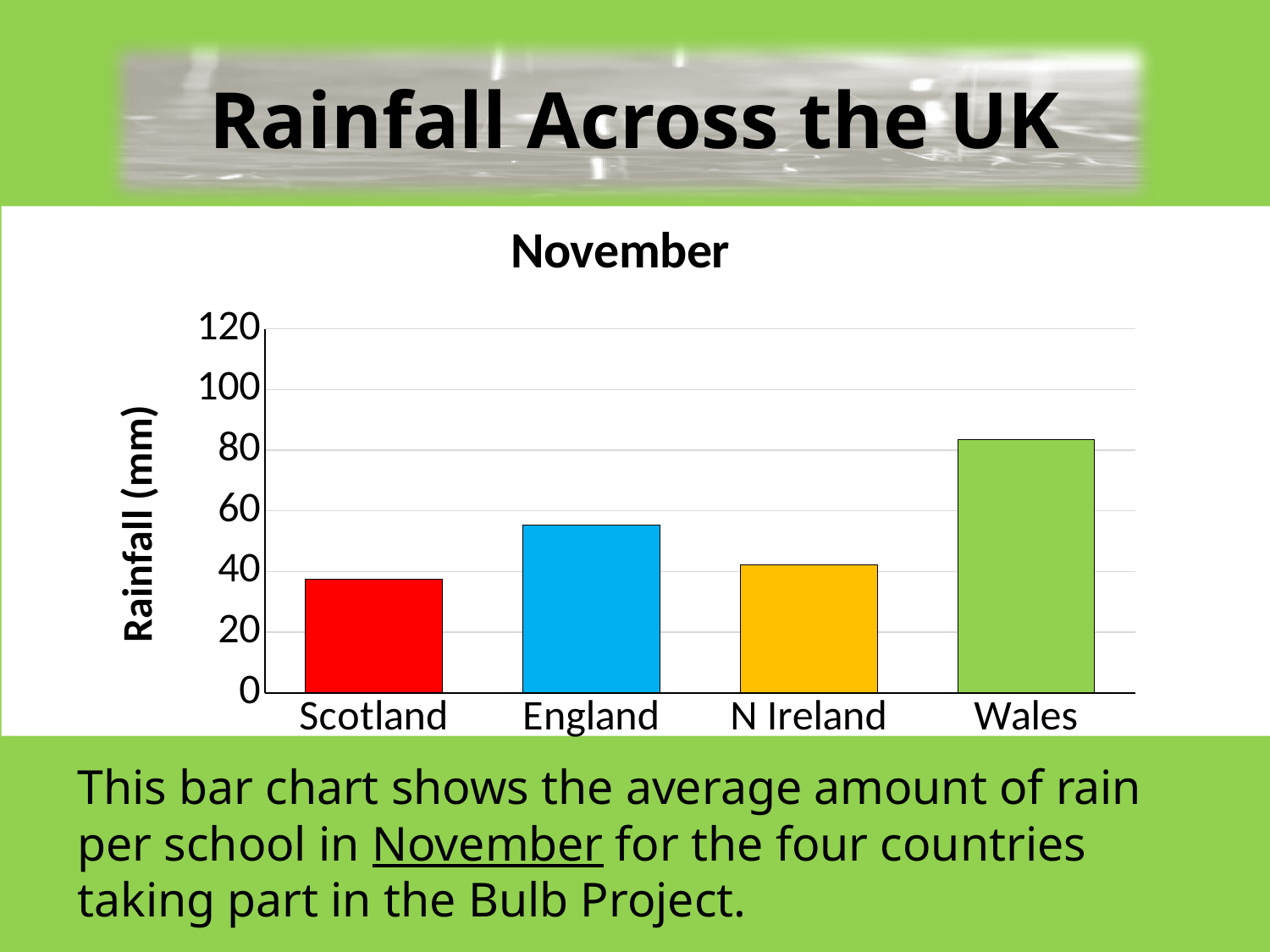
What is the title of the chart? November Is the rainfall value for Wales greater or less than 60? greater Which has the higher rainfall, Wales or England? Wales Is the rainfall value for Scotland greater or less than 60? less Which country has the lowest rainfall in the chart? Scotland What is the label on the vertical axis of the chart? Rainfall (mm) Is the rainfall value for England greater or less than 40? greater How many countries are shown on the chart? 4 Which has the higher rainfall, England or N Ireland? England Which country has the highest rainfall in the chart? Wales What kind of chart is shown on the slide? bar chart